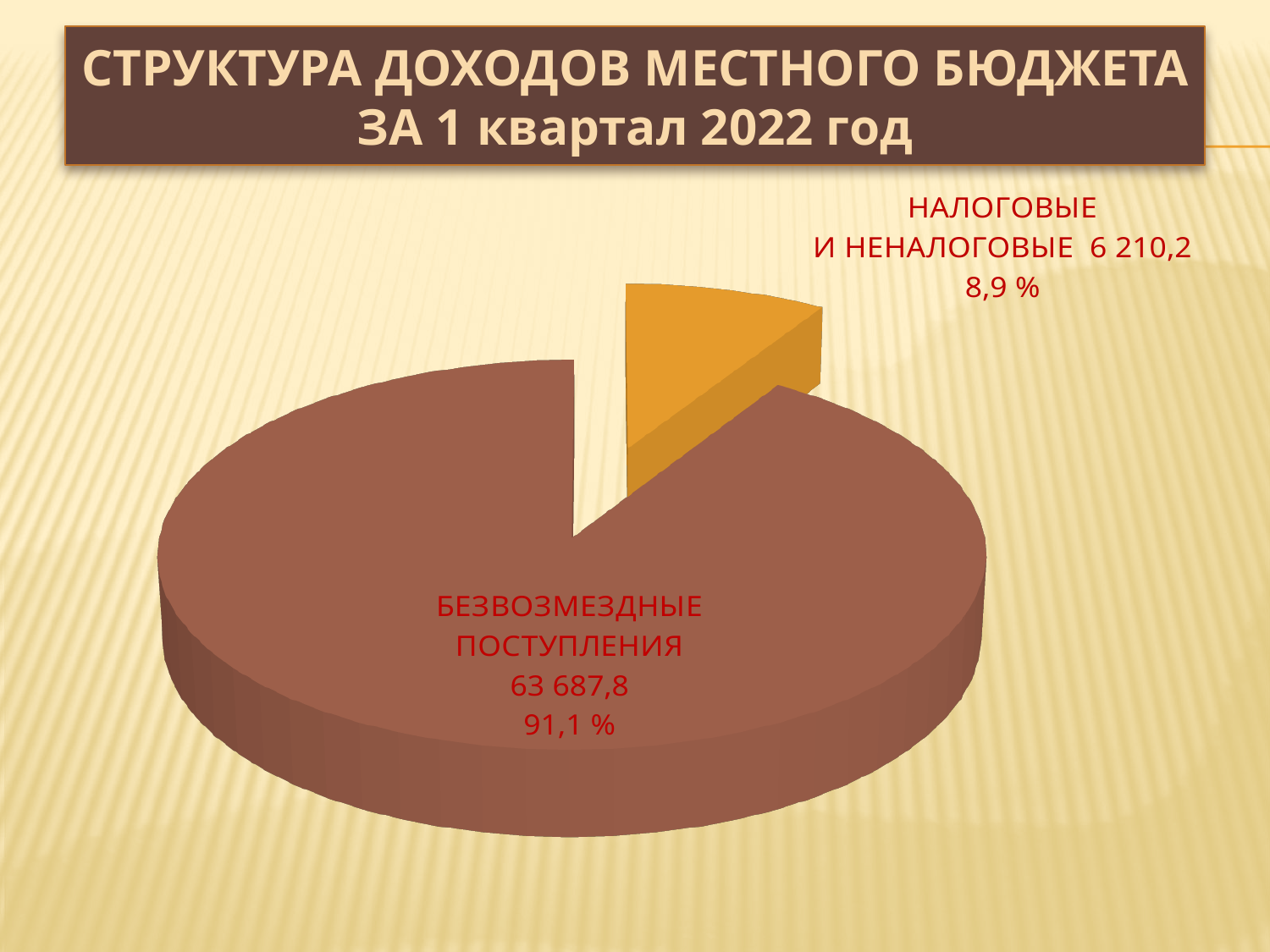
Which slice of the pie is the largest? БЕЗВОЗМЕЗДНЫЕ ПОСТУПЛЕНИЯ How many slices does the pie chart have? 2 What kind of chart is shown on the slide? Pie chart What is the title of the slide? СТРУКТУРА ДОХОДОВ МЕСТНОГО БЮДЖЕТА ЗА 1 квартал 2022 год Which slice of the pie is the smallest? НАЛОГОВЫЕ И НЕНАЛОГОВЫЕ What is the value shown for БЕЗВОЗМЕЗДНЫЕ ПОСТУПЛЕНИЯ? 63 687,8 What share of the pie does НАЛОГОВЫЕ И НЕНАЛОГОВЫЕ represent? 8,9 % What is the difference between the values for БЕЗВОЗМЕЗДНЫЕ ПОСТУПЛЕНИЯ and НАЛОГОВЫЕ И НЕНАЛОГОВЫЕ? 57 477,6 What share of the pie does БЕЗВОЗМЕЗДНЫЕ ПОСТУПЛЕНИЯ represent? 91,1 % What colour is the slice for НАЛОГОВЫЕ И НЕНАЛОГОВЫЕ? Orange What is the value shown for НАЛОГОВЫЕ И НЕНАЛОГОВЫЕ? 6 210,2 Which is larger: БЕЗВОЗМЕЗДНЫЕ ПОСТУПЛЕНИЯ or НАЛОГОВЫЕ И НЕНАЛОГОВЫЕ? БЕЗВОЗМЕЗДНЫЕ ПОСТУПЛЕНИЯ